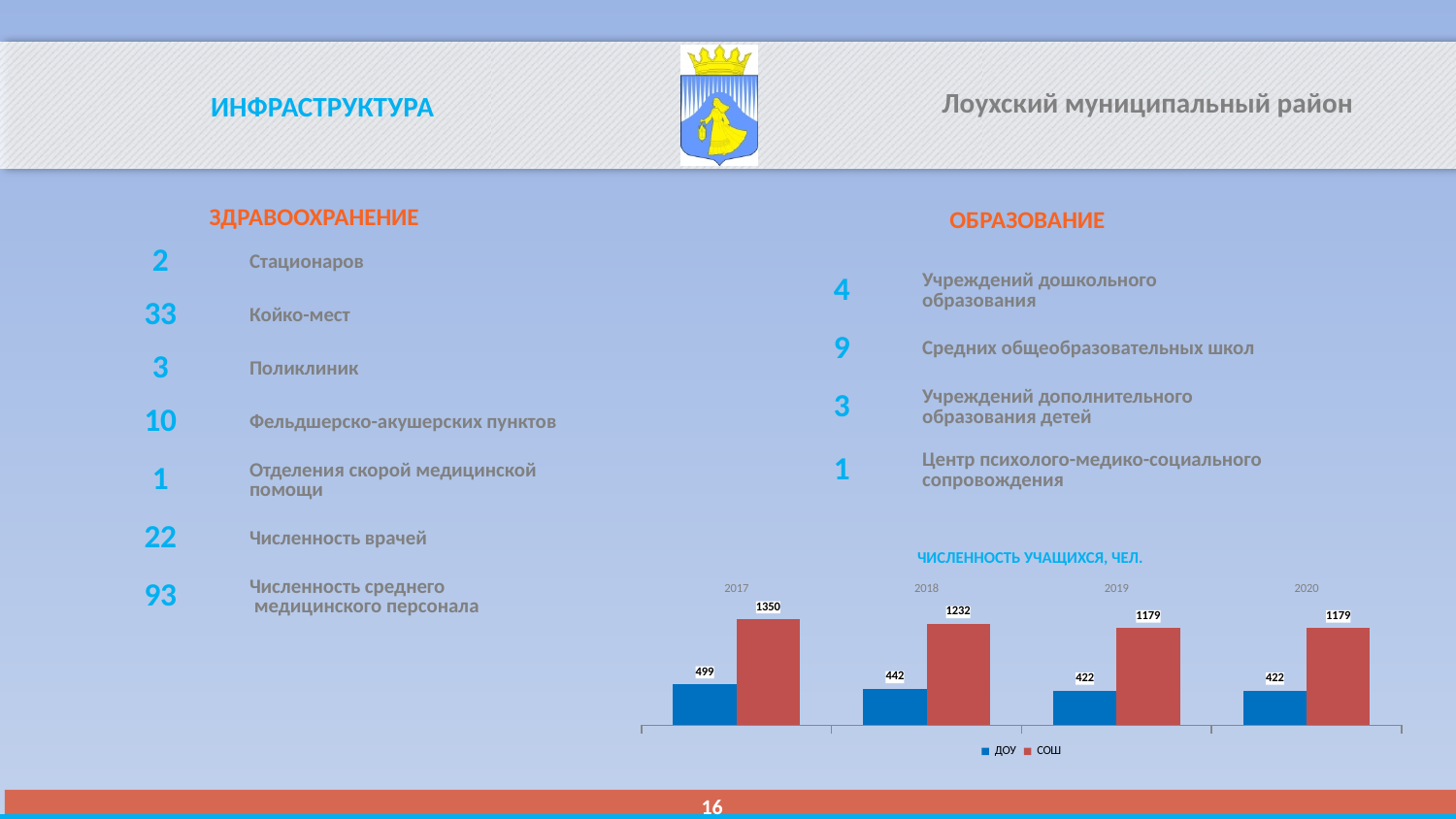
What is the difference between the СОШ values in 2017 and 2018? 118 What is the value for СОШ in 2020? 1179 What kind of chart is shown on the slide? bar chart What is the value for ДОУ in 2017? 499 How many series does the chart legend list? 2 What is the difference between the ДОУ values in 2017 and 2019? 77 How many years are shown on the x axis of the chart? 4 Does the СОШ value rise or fall from 2017 to 2019? fall In which year is the СОШ value highest? 2017 What is the value for СОШ in 2018? 1232 Which is larger in 2019: the ДОУ value or the СОШ value? СОШ In which year is the ДОУ value highest? 2017